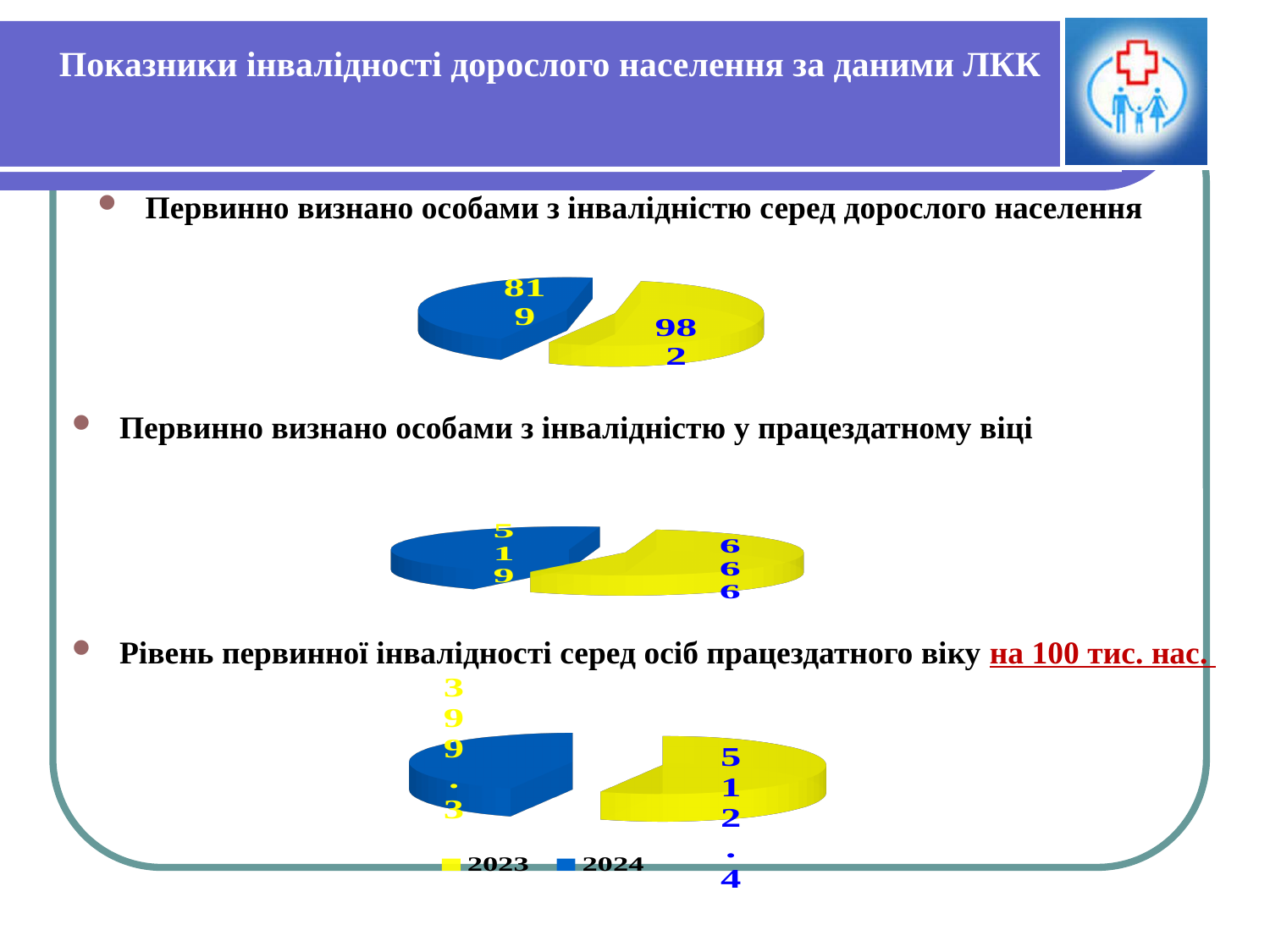
In the middle pie chart (Первинно визнано особами з інвалідністю у працездатному віці), what is the value for 2023? 666 In the top pie chart, which year has the larger value, 2023 or 2024? 2023 In the middle pie chart (Первинно визнано особами з інвалідністю у працездатному віці), what is the value for 2024? 519 In the bottom pie chart (Рівень первинної інвалідності серед осіб працездатного віку на 100 тис. нас.), what is the value for 2023? 512.4 How many entries does the legend at the bottom of the slide list? 2 In the top pie chart (Первинно визнано особами з інвалідністю серед дорослого населення), what is the value for 2023? 982 In the bottom pie chart (Рівень первинної інвалідності серед осіб працездатного віку на 100 тис. нас.), what is the value for 2024? 399.3 In the top pie chart, what is the difference between the 2023 and 2024 values? 163 In the middle pie chart, what is the difference between the 2023 and 2024 values? 147 In the bottom pie chart, what is the difference between the 2023 and 2024 values? 113.1 What type of chart is used for the three charts on the slide? Pie chart In the top pie chart (Первинно визнано особами з інвалідністю серед дорослого населення), what is the value for 2024? 819